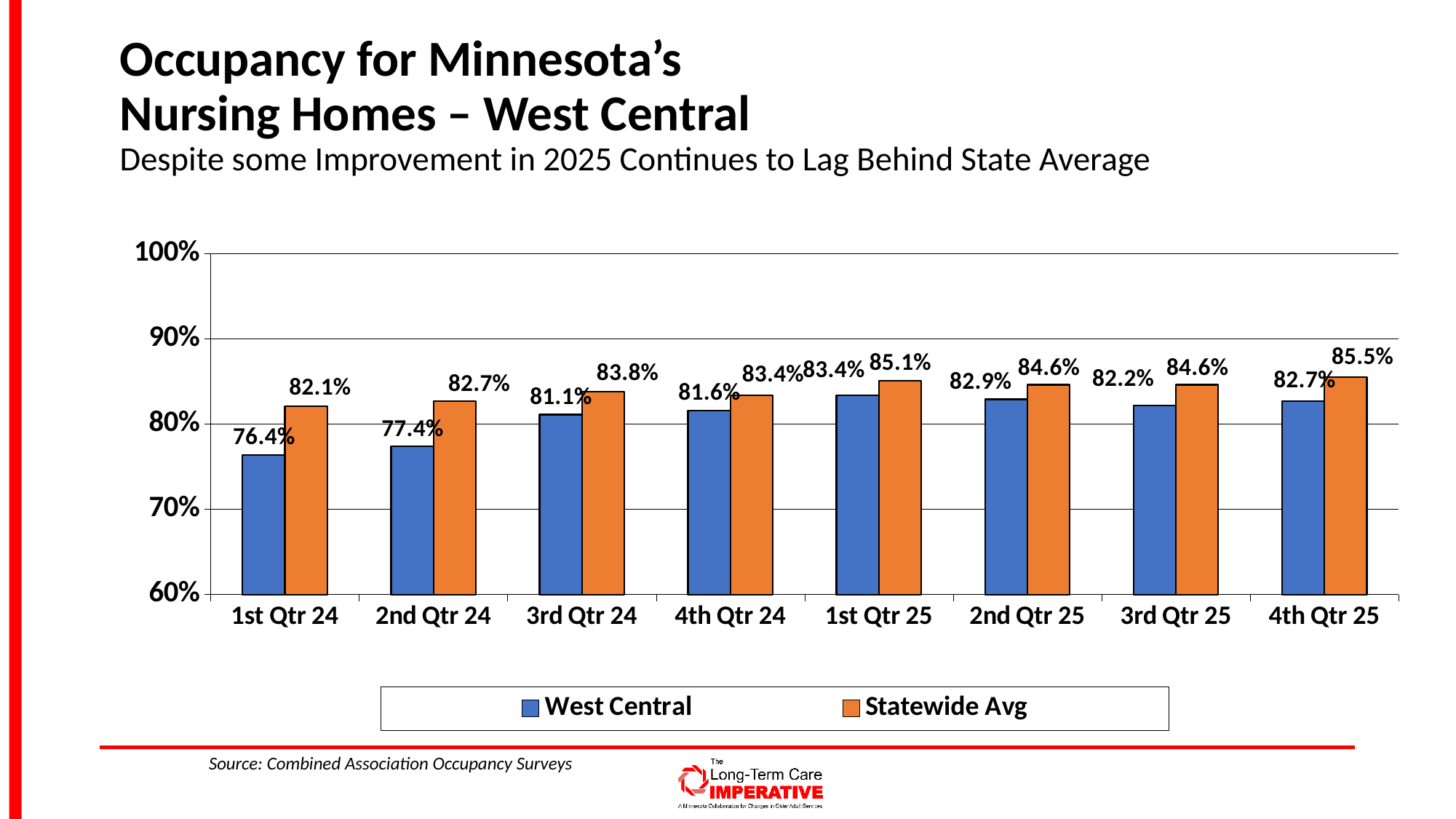
Does the West Central occupancy rise or fall from 1st Qtr 24 to 1st Qtr 25? rise What is the West Central occupancy value for 1st Qtr 24? 76.4% How many quarters are shown on the x axis? 8 What kind of chart is shown on the slide? bar chart What colour represents the Statewide Avg series in the legend? orange What is the Statewide Avg occupancy value for 4th Qtr 25? 85.5% In which quarter is the Statewide Avg occupancy lowest? 1st Qtr 24 How many series does the legend list? 2 What is the difference between the Statewide Avg and West Central values in 1st Qtr 24? 5.7 percentage points In 3rd Qtr 24, which is larger: West Central or Statewide Avg? Statewide Avg In which quarter is the West Central occupancy highest? 1st Qtr 25 Is the West Central value for 1st Qtr 24 greater or less than 80%? less